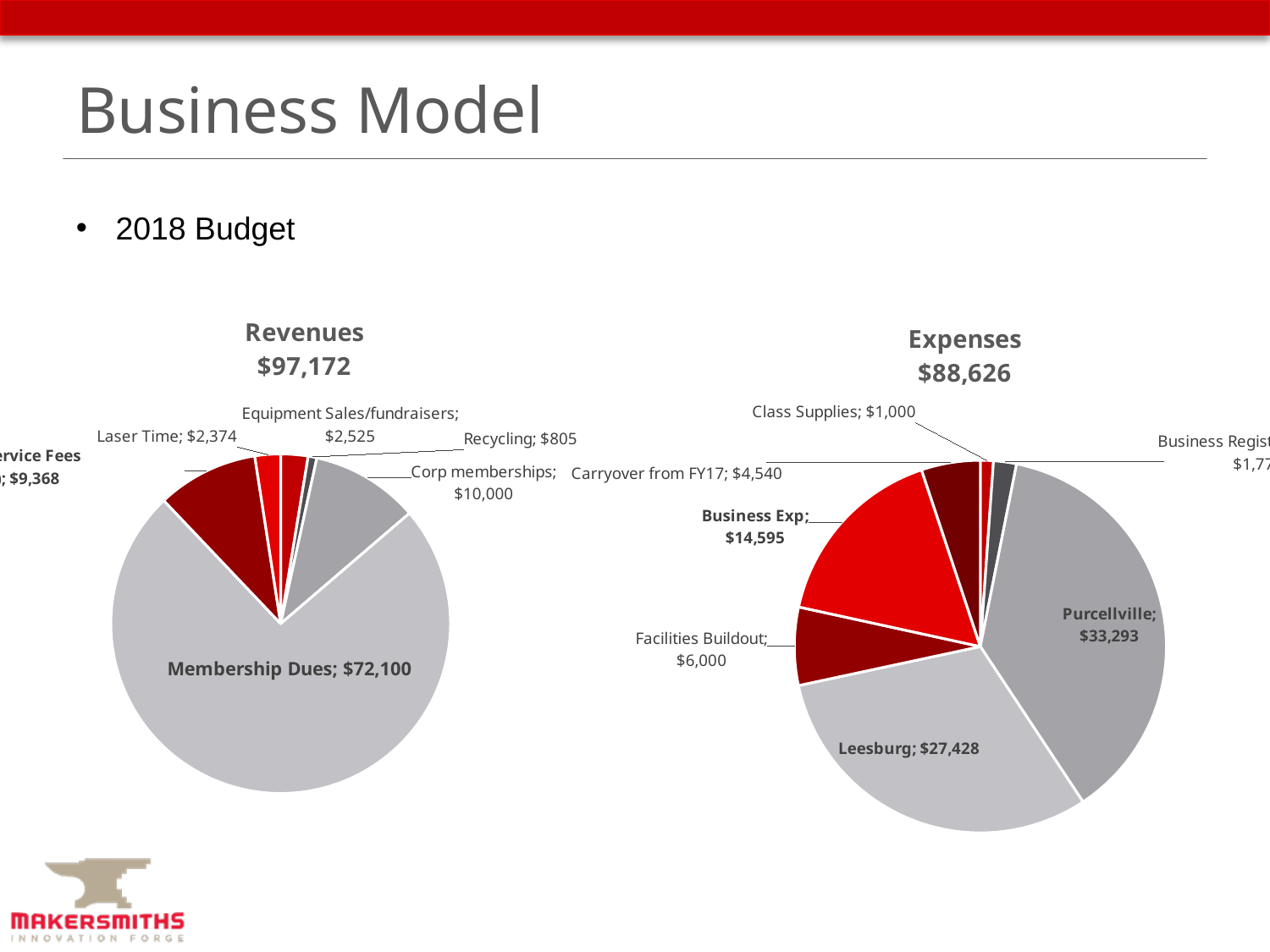
On the Expenses pie chart, what is the value for Business Exp? $14,595 On the Expenses pie chart, what is the value for Purcellville? $33,293 On the Expenses pie chart, which category has the largest slice? Purcellville On the Revenues pie chart, what is the difference between Membership Dues and Corp memberships? $62,100 What total is shown under the Expenses chart title? $88,626 On the Revenues pie chart, which category has the smallest slice? Recycling What type of chart is used for Revenues and Expenses on this slide? Pie chart On the Revenues pie chart, which category has the largest slice? Membership Dues On the Revenues pie chart, what is the value for Membership Dues? $72,100 On the Expenses pie chart, which is larger, Facilities Buildout or Carryover from FY17? Facilities Buildout On the Expenses pie chart, what is the difference between Purcellville and Leesburg? $5,865 On the Revenues pie chart, what is the value for Corp memberships? $10,000